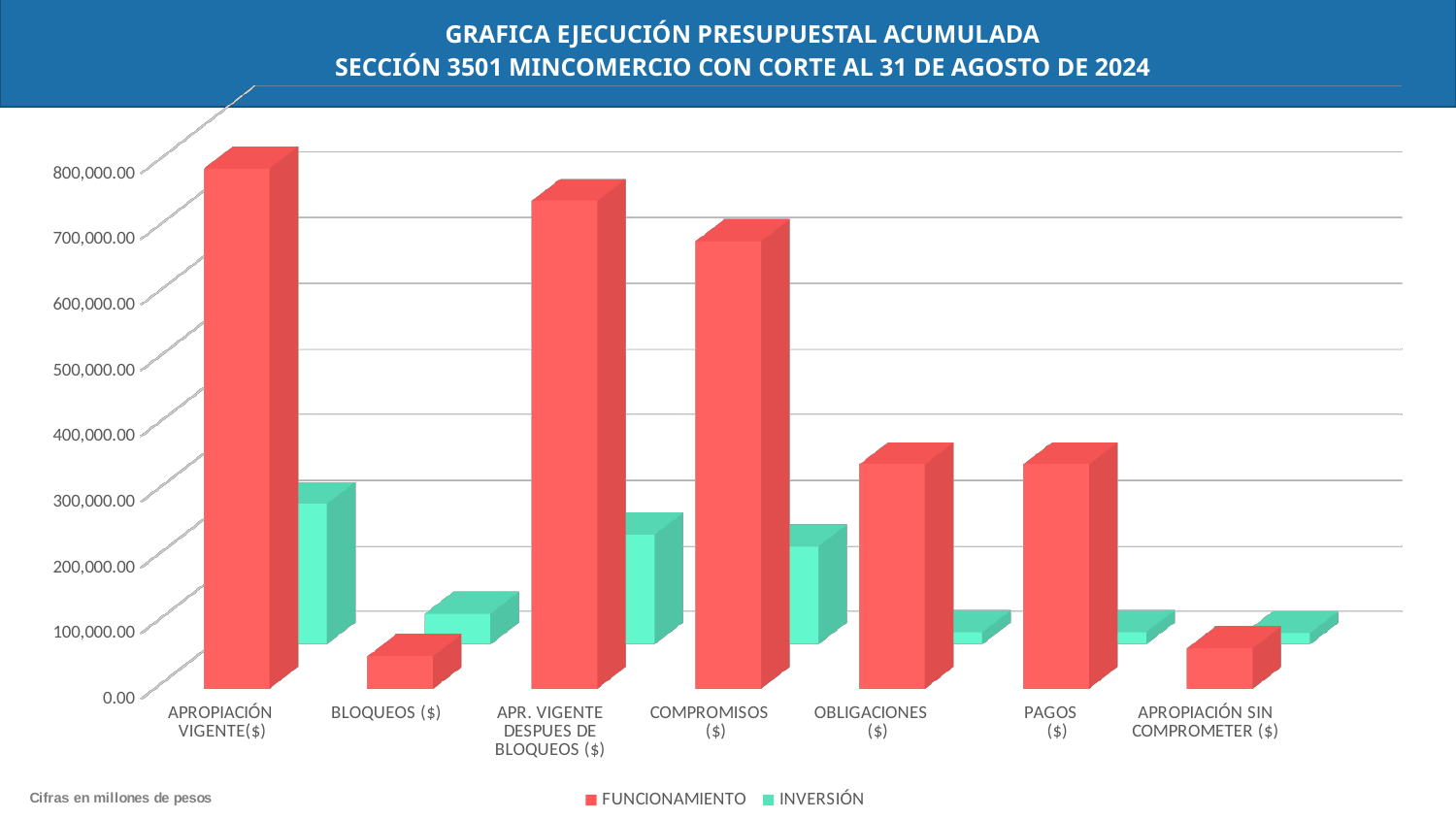
Is the FUNCIONAMIENTO value for APR. VIGENTE DESPUES DE BLOQUEOS ($) greater or less than 700,000.00? greater Is the FUNCIONAMIENTO value for OBLIGACIONES ($) greater or less than 400,000.00? less Which colour represents the INVERSIÓN series in the legend? green Is the FUNCIONAMIENTO value for BLOQUEOS ($) greater or less than 100,000.00? less Which category has the highest FUNCIONAMIENTO value? APROPIACIÓN VIGENTE($) How many series does the legend list? 2 Which is larger, the FUNCIONAMIENTO value for COMPROMISOS ($) or the FUNCIONAMIENTO value for PAGOS ($)? COMPROMISOS ($) What kind of chart is shown on the slide? bar chart How many categories are shown on the x axis? 7 Which category has the highest INVERSIÓN value? APROPIACIÓN VIGENTE($) For APROPIACIÓN VIGENTE($), which series has the larger value, FUNCIONAMIENTO or INVERSIÓN? FUNCIONAMIENTO